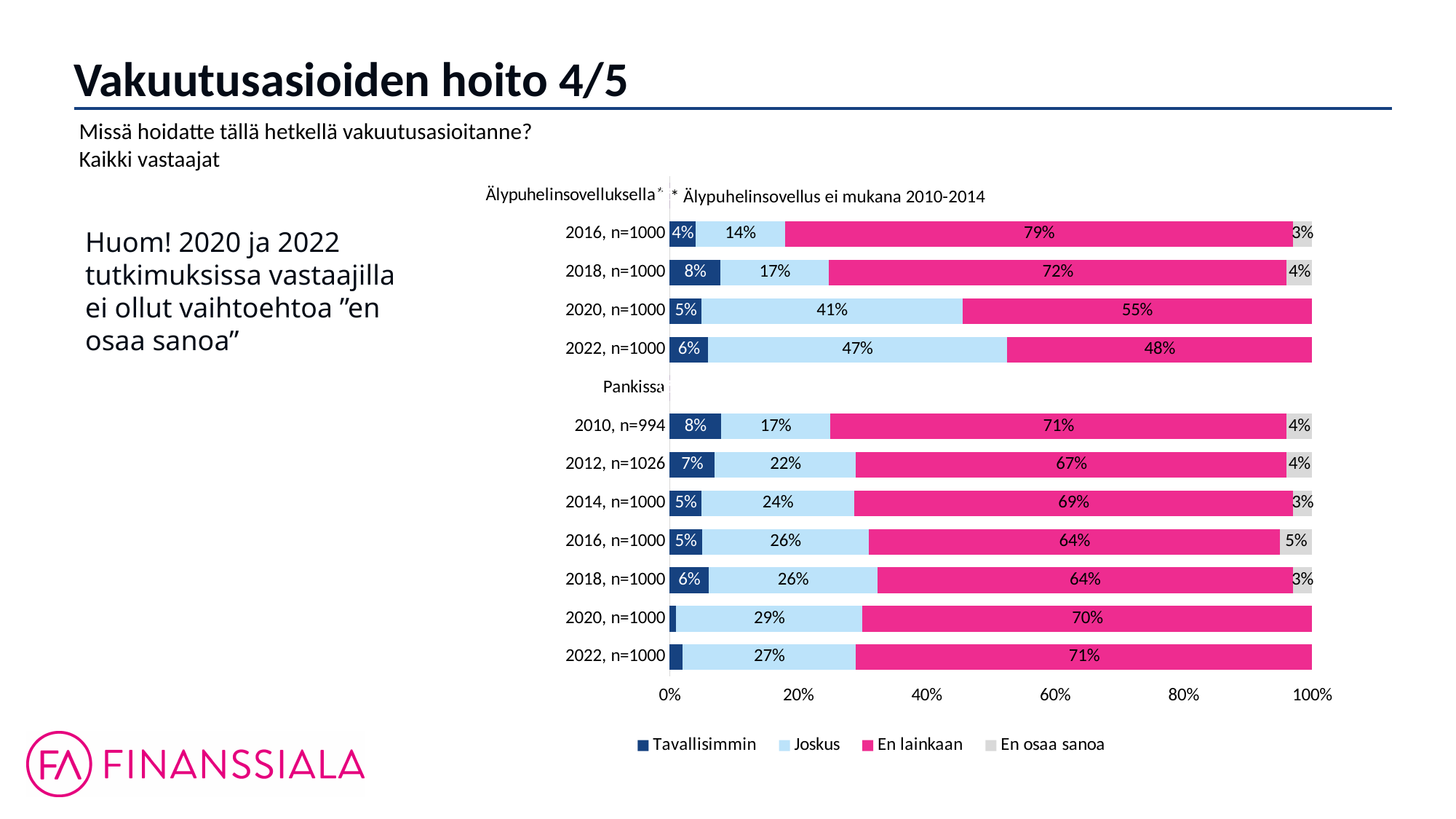
What is the 'En lainkaan' value for Älypuhelinsovelluksella in 2016, n=1000? 79% What is the 'Joskus' value for Älypuhelinsovelluksella in 2022, n=1000? 47% How many series does the legend list? 4 By how many percentage points did the 'En lainkaan' value for Älypuhelinsovelluksella fall from 2016 to 2022? 31 percentage points Among the Pankissa rows, which year has the lowest 'Joskus' value? 2010, n=994 How many year rows are shown under Pankissa? 7 What is the 'Tavallisimmin' value for Pankissa in 2012, n=1026? 7% What is the 'En lainkaan' value for Pankissa in 2010, n=994? 71% What kind of chart is shown on the slide? Stacked bar chart Which is larger: the 'Joskus' value for Pankissa in 2012 or the 'Joskus' value for Älypuhelinsovelluksella in 2018? Pankissa 2012 Among the Älypuhelinsovelluksella rows, which year has the highest 'Joskus' value? 2022, n=1000 Does the 'En lainkaan' value for Älypuhelinsovelluksella rise or fall from 2016 to 2022? Fall